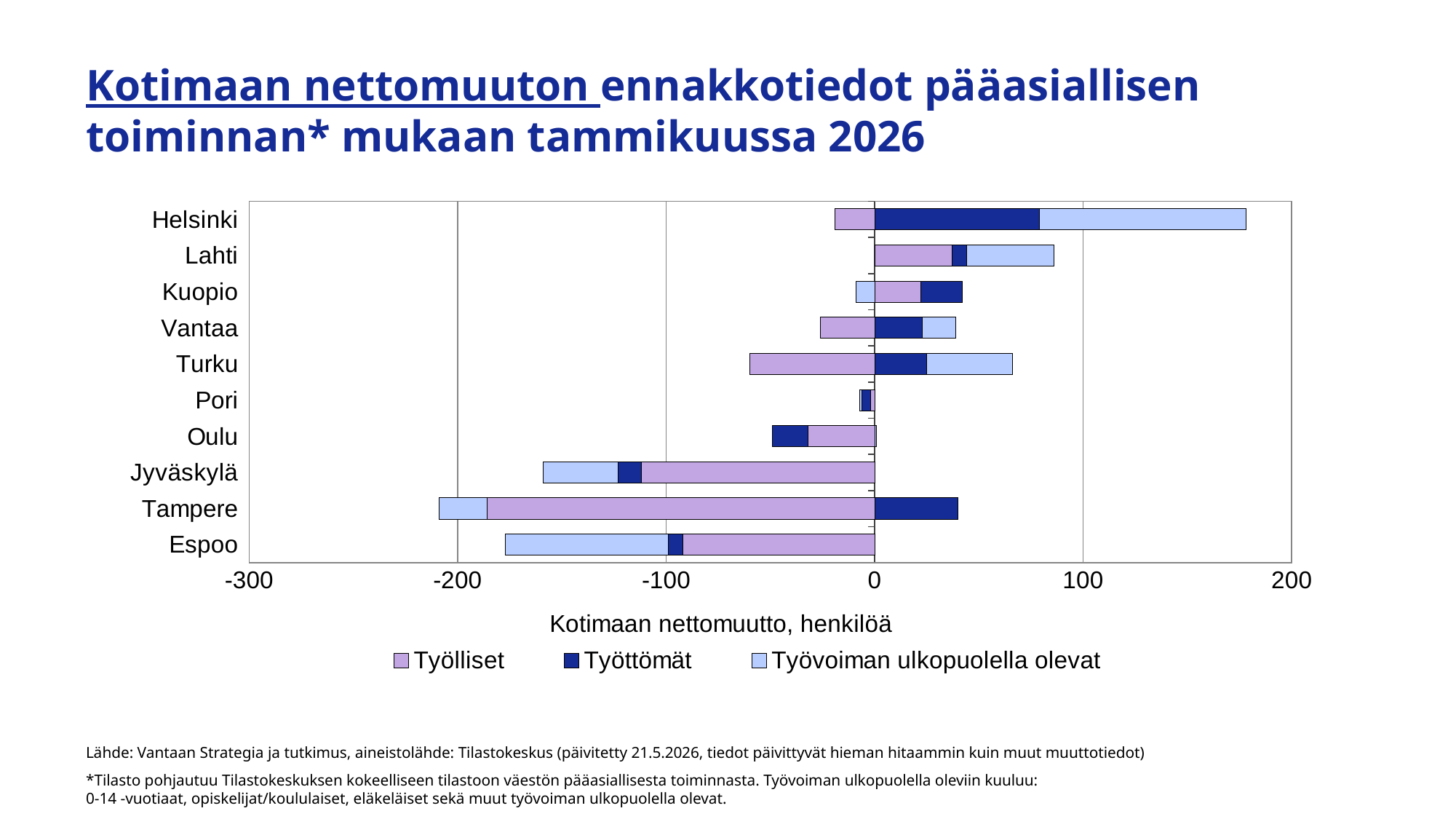
What is the title of the horizontal axis? Kotimaan nettomuutto, henkilöä Is the value of the Työlliset segment for Turku greater or less than -100? greater Which series is shown in the darkest blue colour in the legend? Työttömät Which city has the most negative Työlliset segment? Tampere How many cities are listed on the vertical axis of the chart? 10 Is the value of the Työlliset segment for Tampere greater or less than -100? less Which is larger, the Työvoiman ulkopuolella olevat segment for Helsinki or for Lahti? Helsinki What kind of chart is shown on the slide? bar chart Is the value of the Työttömät segment for Helsinki greater or less than 100? less Which city has the largest positive Työvoiman ulkopuolella olevat segment? Helsinki How many series does the legend list? 3